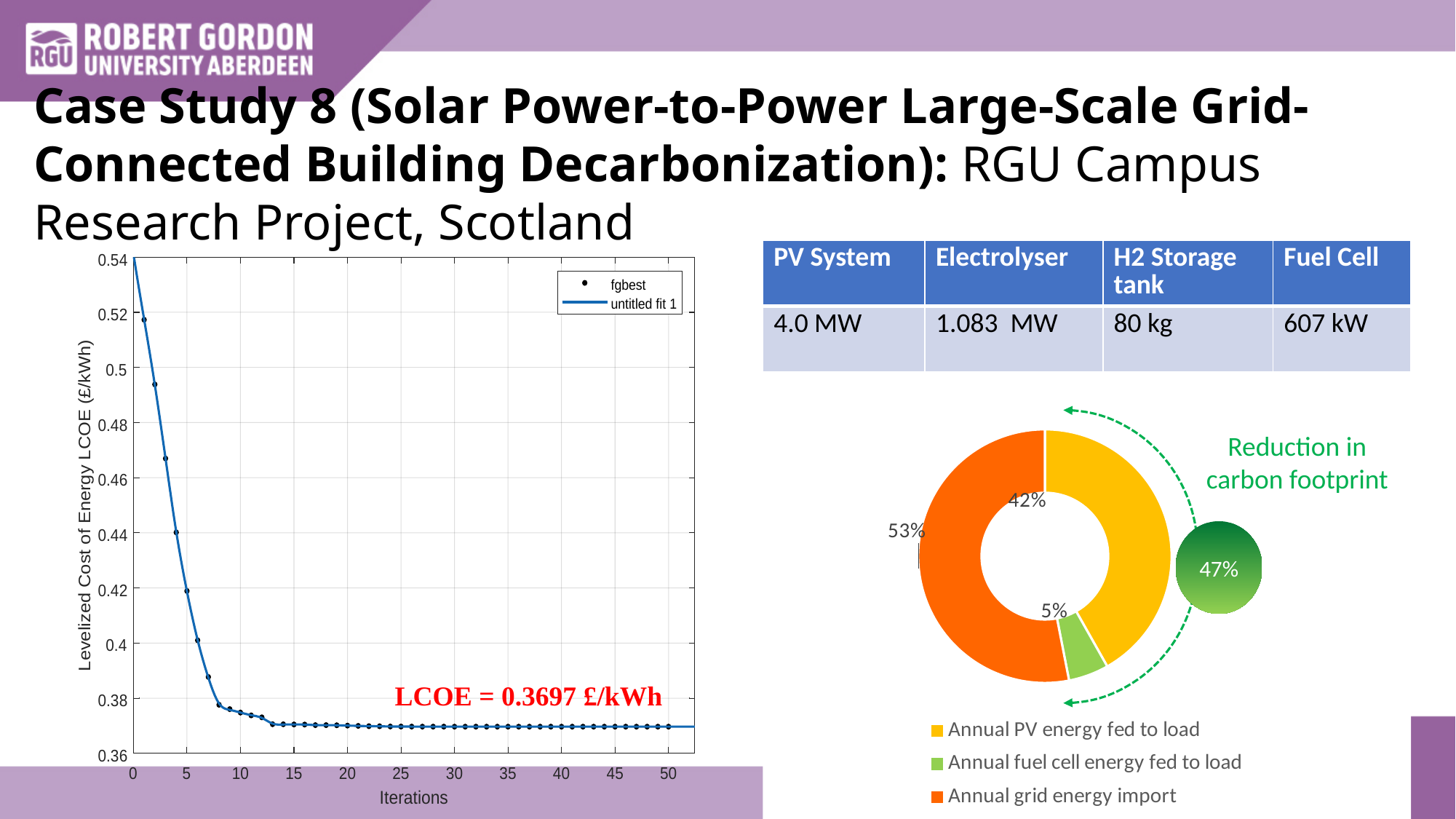
In the line chart on the left, do the values rise or fall as the number of iterations increases? fall In the donut chart, which is larger: Annual PV energy fed to load or Annual grid energy import? Annual grid energy import In the donut chart, how many categories are shown? 3 In the line chart on the left, what is the final LCOE value printed on the chart? 0.3697 £/kWh In the donut chart, what share is Annual PV energy fed to load? 42% In the donut chart, which category has the smallest share? Annual fuel cell energy fed to load In the line chart on the left, how many entries does the legend list? 2 In the line chart on the left, is the value at iteration 20 greater or less than 0.38? less In the donut chart, what share is Annual grid energy import? 53% In the donut chart, what is the difference between the Annual grid energy import share and the Annual PV energy fed to load share? 11% In the donut chart, what share is Annual fuel cell energy fed to load? 5% In the donut chart, which category has the largest share? Annual grid energy import